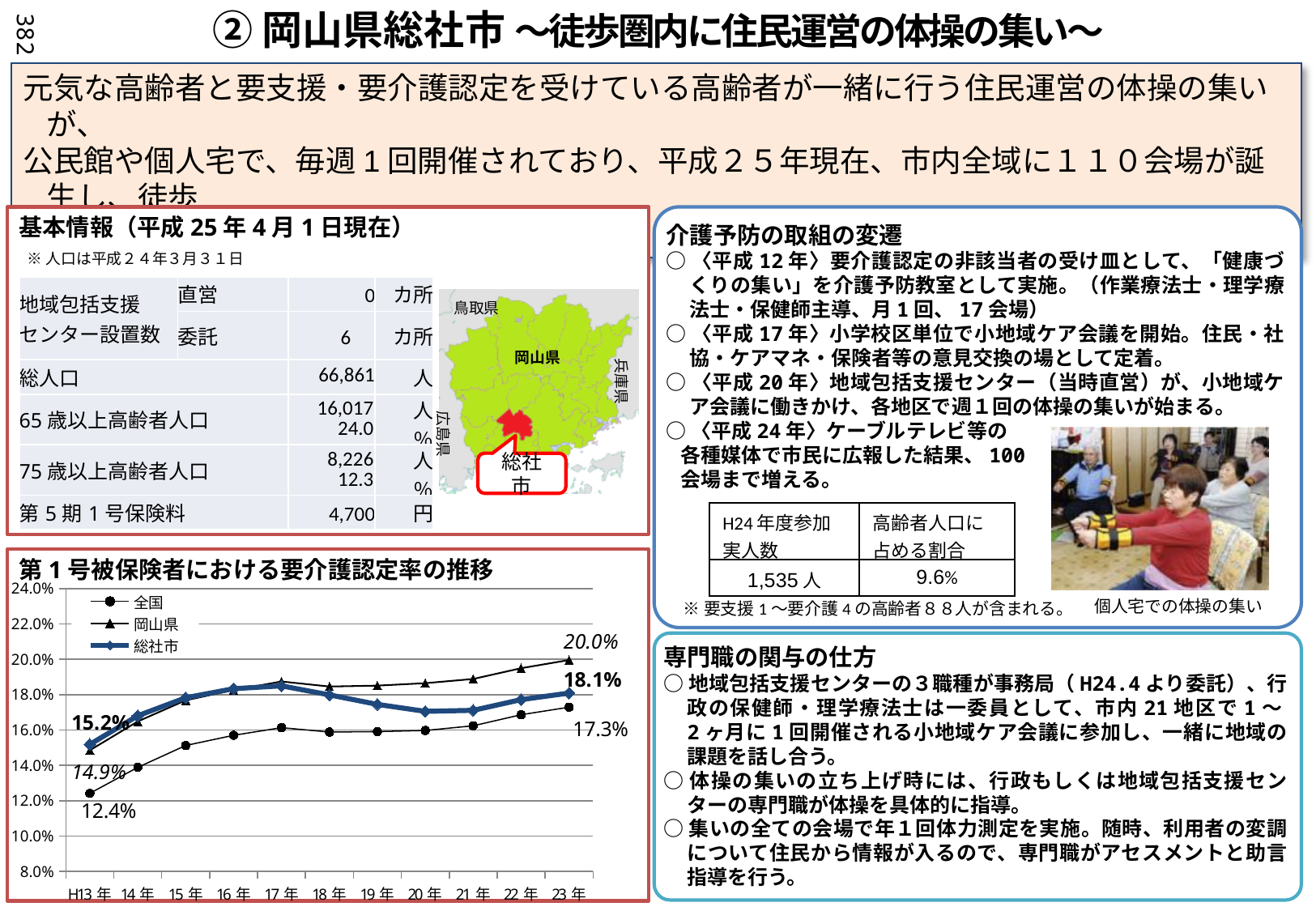
In the 要介護認定率の推移 chart, is the value for 全国 in H15年 greater or less than 16.0%? less What kind of chart is shown under the title 第1号被保険者における要介護認定率の推移? line chart In the 要介護認定率の推移 chart, what is the value for 全国 in H23年? 17.3% In the 要介護認定率の推移 chart, does the 全国 series generally rise or fall from H13年 to H23年? rise In the 要介護認定率の推移 chart, what is the value for 総社市 in H13年? 15.2% How many series does the legend of the 要介護認定率の推移 chart list? 3 In the 要介護認定率の推移 chart, which series has the highest value in H23年? 岡山県 In the 要介護認定率の推移 chart, which series has the lowest value in H13年? 全国 In the 要介護認定率の推移 chart, what is the difference between the 岡山県 and 総社市 values in H23年? 1.9% In the 要介護認定率の推移 chart, what is the value for 岡山県 in H23年? 20.0% How many years are plotted along the x axis of the 要介護認定率の推移 chart? 11 In the 要介護認定率の推移 chart, what is the value for 全国 in H13年? 12.4%